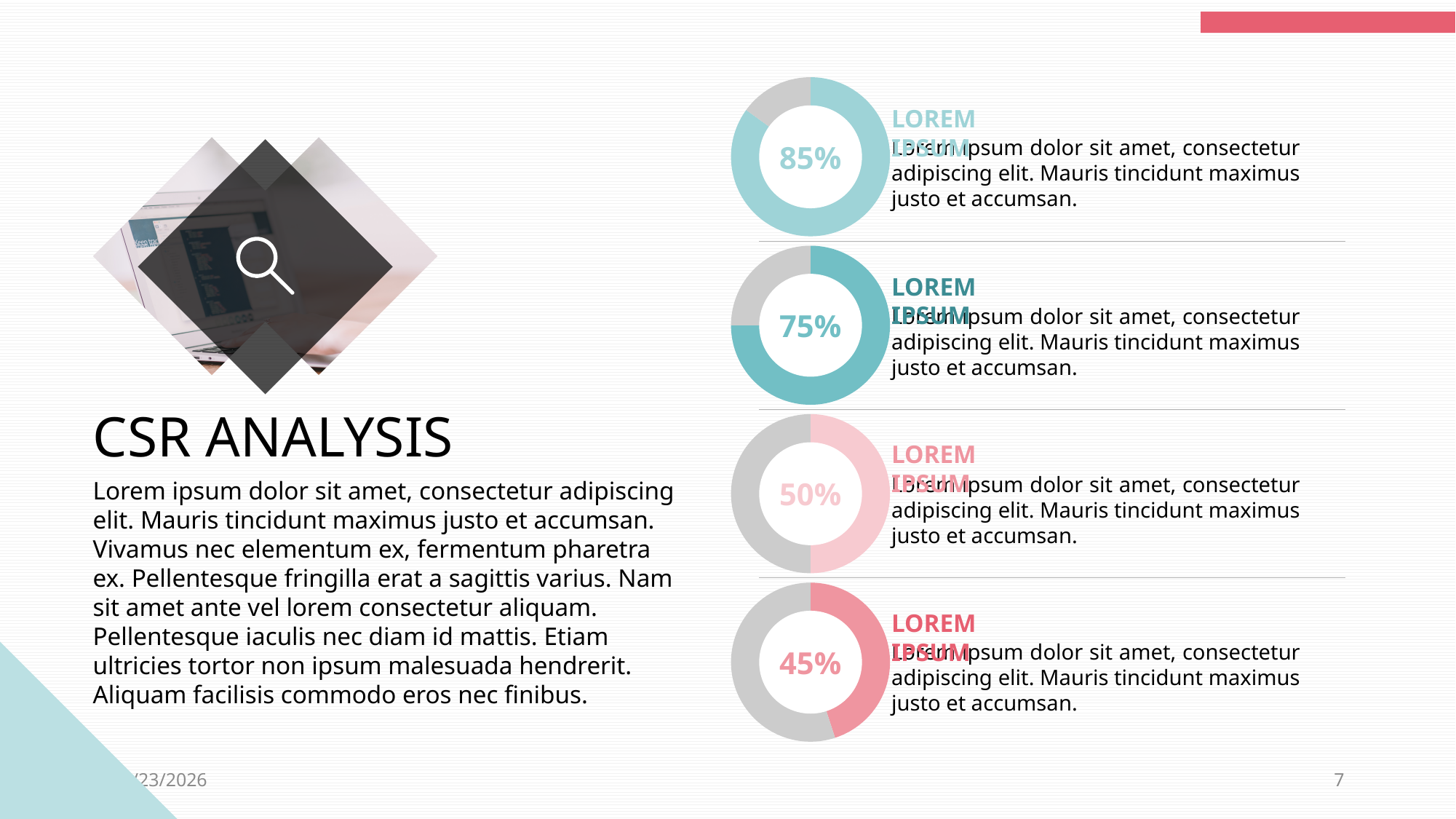
What value is shown in the centre of the top donut chart? 85% What is the difference between the value in the top donut chart and the value in the bottom donut chart? 40% What kind of chart is used to display the percentages on the right side of the slide? Donut chart What value is shown in the centre of the third donut chart from the top? 50% Which is larger, the value in the second donut chart or the value in the third donut chart? The second donut chart (75%) Which donut chart on the slide shows the lowest percentage? The bottom one (45%) What value is shown in the centre of the second donut chart from the top? 75% What value is shown in the centre of the bottom donut chart? 45% Do the percentage values decrease or increase going from the top donut chart to the bottom one? Decrease What is the difference between the values of the second and third donut charts from the top? 25% Which donut chart on the slide shows the highest percentage? The top one (85%) How many donut charts are shown on the slide? 4